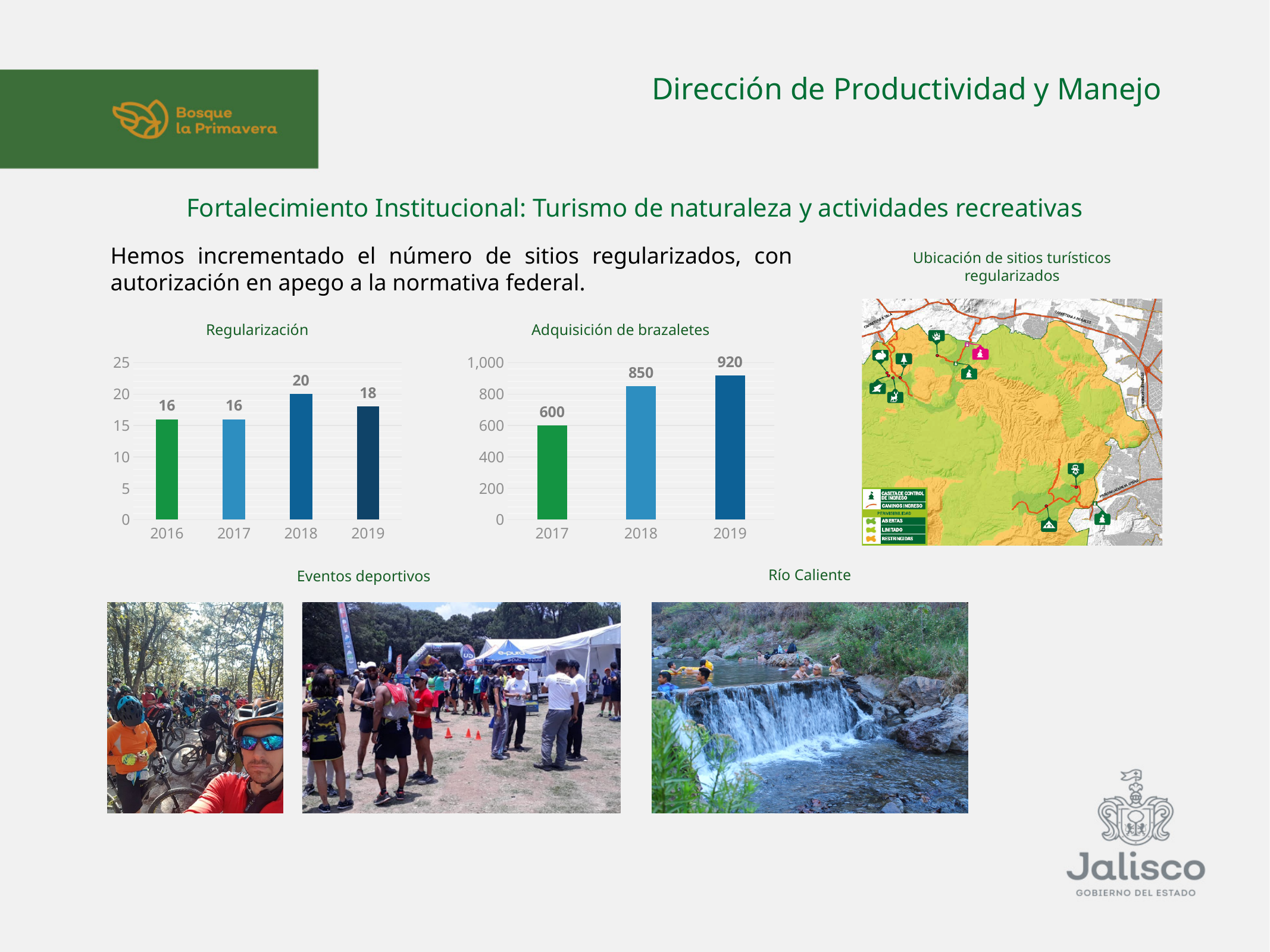
In the 'Regularización' chart, what is the difference between the values for 2018 and 2019? 2 In the 'Regularización' chart, how many years are shown on the x axis? 4 In the 'Regularización' chart, which year has the highest value? 2018 In the 'Adquisición de brazaletes' chart, what is the value for 2019? 920 In the 'Regularización' chart, what is the value for 2019? 18 In the 'Adquisición de brazaletes' chart, what is the value for 2017? 600 In the 'Regularización' chart, is the value for 2018 greater or less than 15? greater What kind of chart is the 'Adquisición de brazaletes' chart? bar chart In the 'Adquisición de brazaletes' chart, do the values rise or fall from 2017 to 2019? rise In the 'Adquisición de brazaletes' chart, which year has the lowest value? 2017 In the 'Regularización' chart, what is the value for 2018? 20 In the 'Adquisición de brazaletes' chart, what is the difference between the values for 2019 and 2018? 70